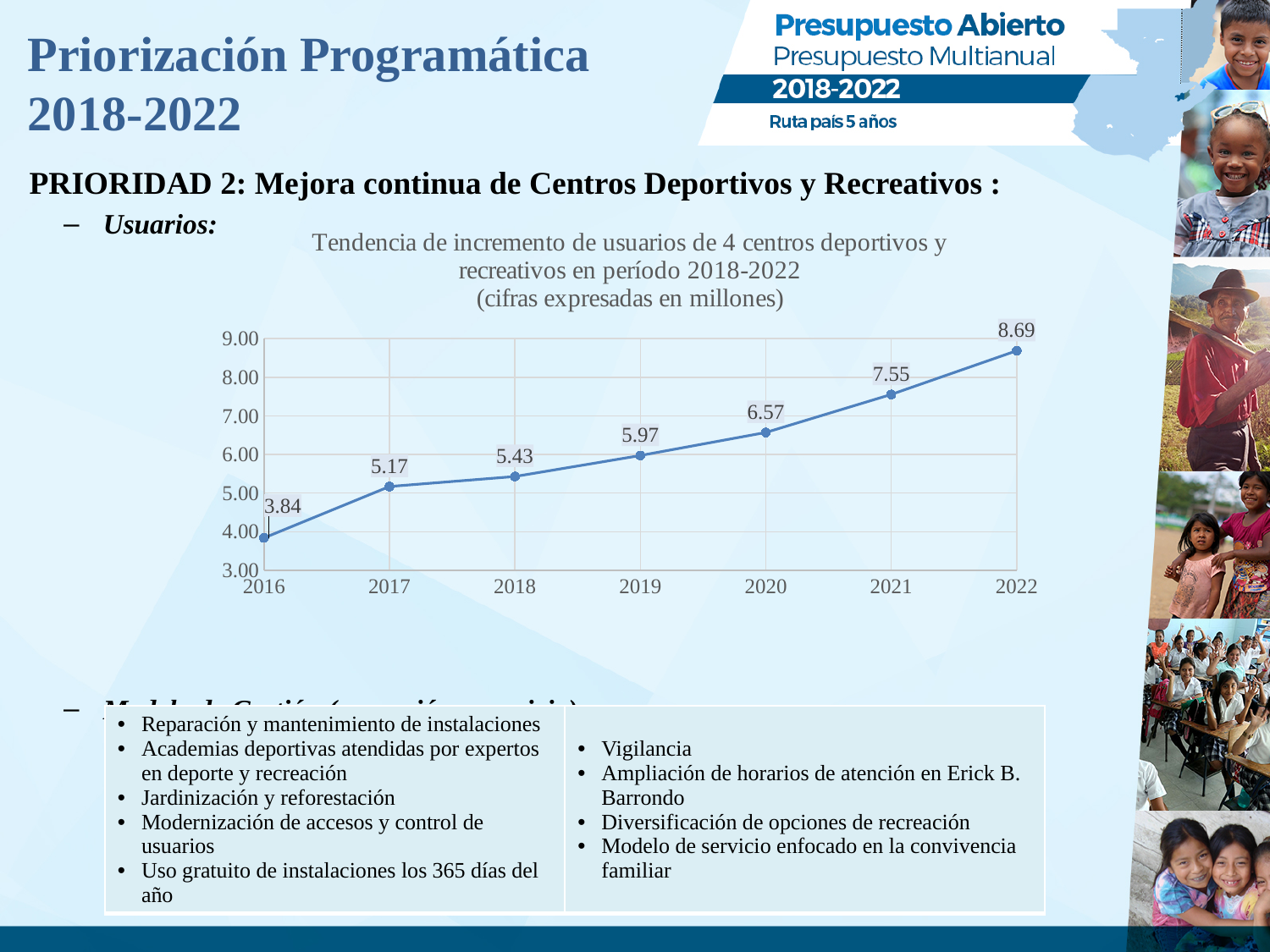
Which is larger, the value for 2018 or the value for 2020? 2020 Which year has the lowest value? 2016 How many years are plotted on the chart? 7 What is the value for 2016? 3.84 What is the value for 2022? 8.69 What is the difference between the values for 2021 and 2020? 0.98 Is the value for 2021 greater or less than 7.00? greater What is the difference between the values for 2022 and 2016? 4.85 Do the values rise or fall from 2016 to 2022? rise What is the value for 2019? 5.97 What kind of chart is shown? line chart Which year has the highest value? 2022